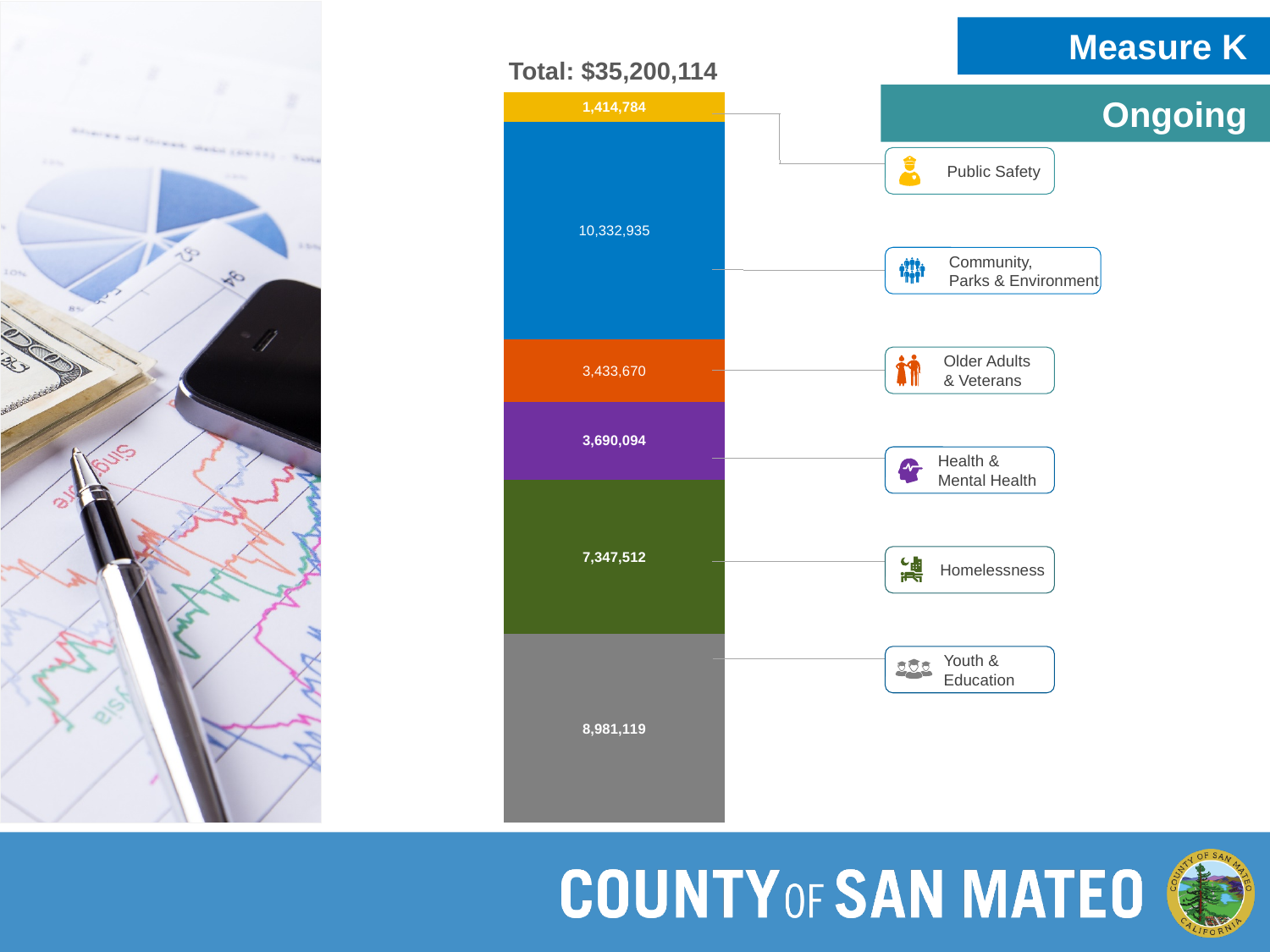
What is the value for Public Safety? 1,414,784 How many categories are shown in the stacked bar? 6 What is the total of the stacked bar? $35,200,114 What is the value for Youth & Education? 8,981,119 Which category has the highest value? Community, Parks & Environment What is the value for Homelessness? 7,347,512 What is the difference between the values for Youth & Education and Homelessness? 1,633,607 What is the difference between the values for Health & Mental Health and Older Adults & Veterans? 256,424 What is the value for Community, Parks & Environment? 10,332,935 What colour is the segment for Health & Mental Health? Purple Which category has the lowest value? Public Safety Which is larger, the value for Homelessness or the value for Older Adults & Veterans? Homelessness